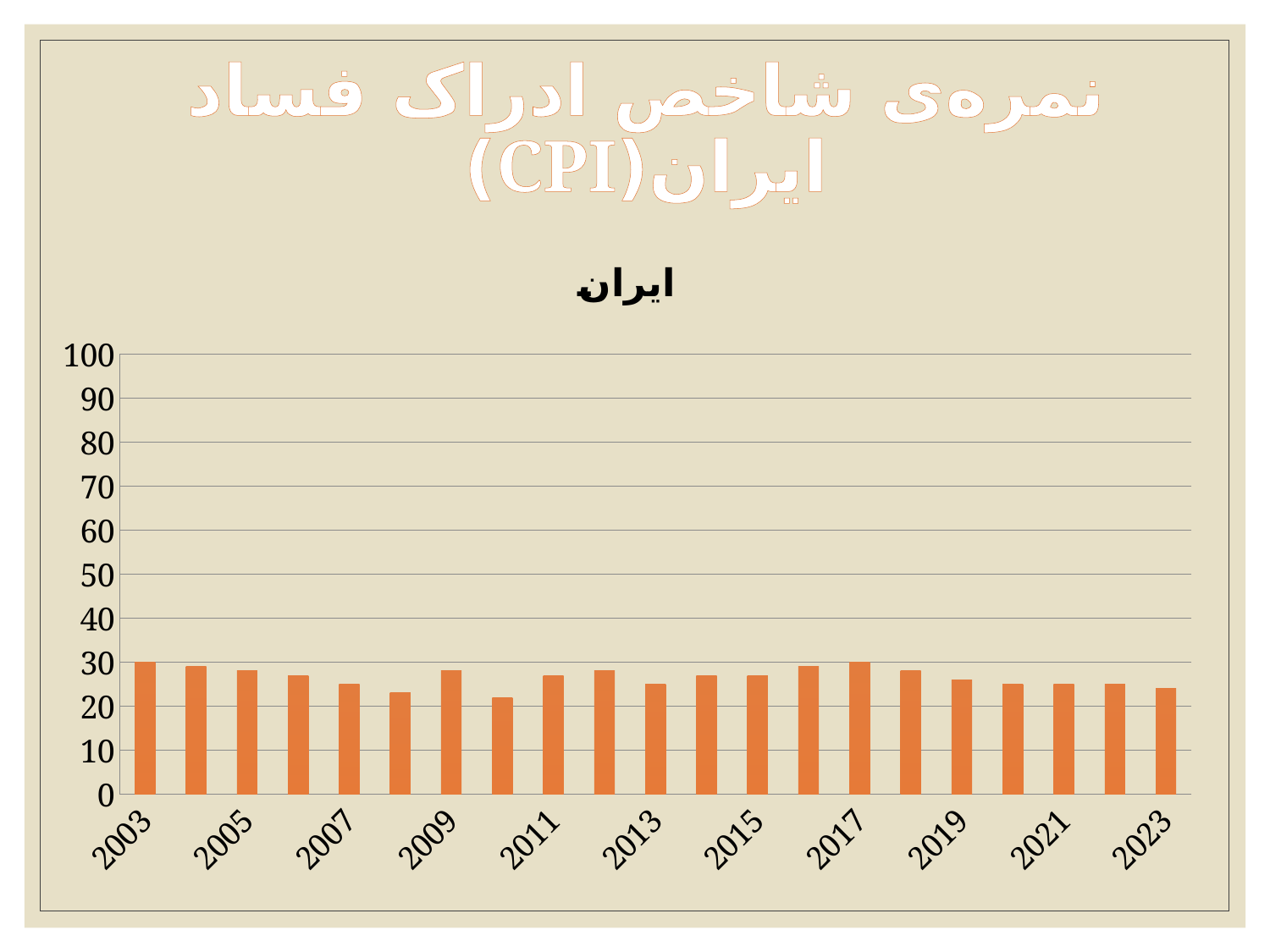
Which year has the lowest value in the chart? 2010 Which is larger, the value for 2017 or the value for 2023? 2017 Which is larger, the value for 2008 or the value for 2009? 2009 What is the title shown directly above the chart? ایران Is the value for 2017 greater or less than 40? less Which is larger, the value for 2003 or the value for 2010? 2003 Is the value for 2010 greater or less than 30? less Is the value for 2003 greater or less than 20? greater Do the values rise or fall from 2017 to 2023? fall How many years (bars) are plotted in the chart? 21 What kind of chart is shown on the slide? bar chart